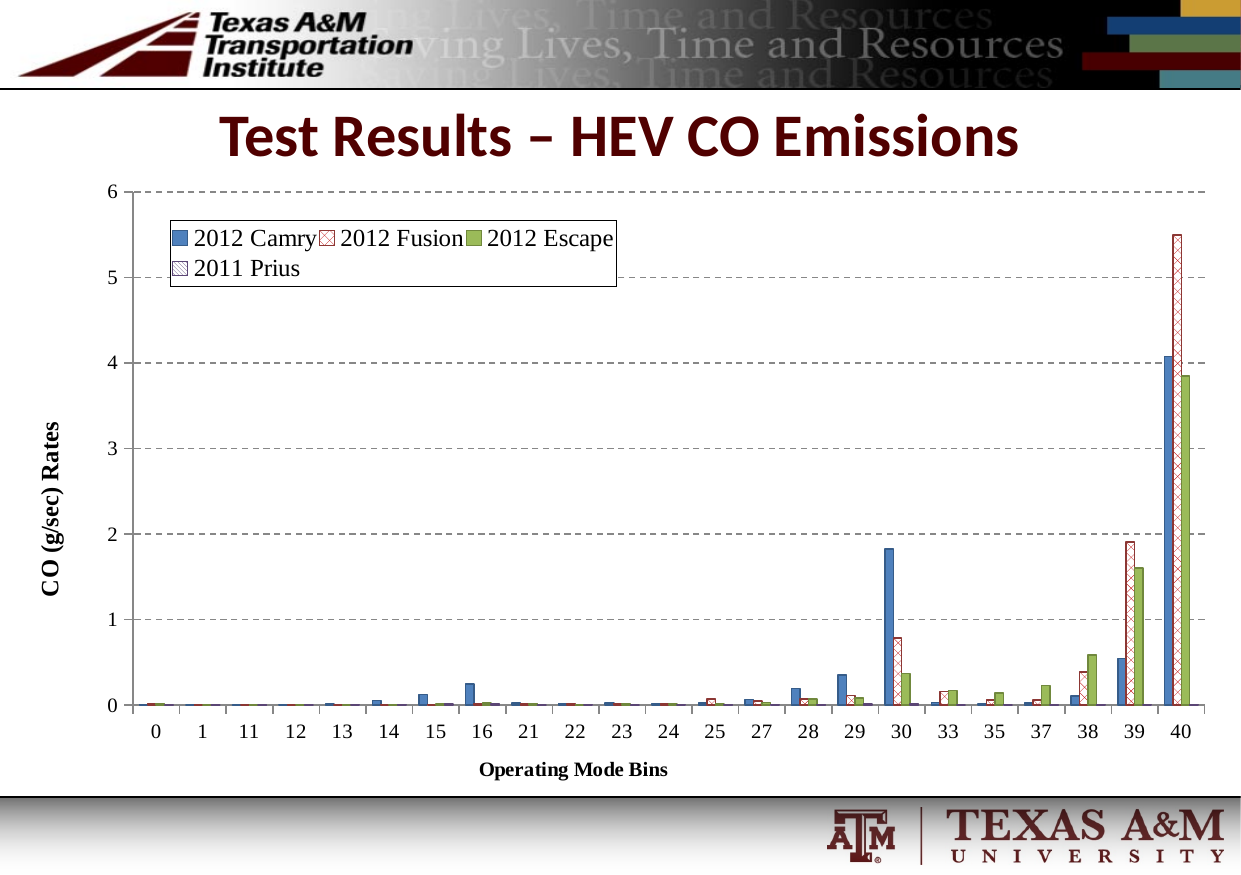
Which series has the highest value at operating mode bin 40? 2012 Fusion What is the title of the chart? Test Results – HEV CO Emissions At which operating mode bin does the 2012 Fusion reach its highest value? 40 What is the label of the y axis? CO (g/sec) Rates Is the value for 2012 Camry at bin 30 greater or less than 1? greater Which is larger at bin 39, the value for 2012 Fusion or 2012 Escape? 2012 Fusion Which is larger at bin 30, the value for 2012 Camry or 2012 Fusion? 2012 Camry Is the value for 2012 Escape at bin 40 greater or less than 4? less How many operating mode bins are shown on the x axis? 23 How many series does the legend list? 4 Is the value for 2012 Fusion at bin 40 greater or less than 5? greater What kind of chart is shown on the slide? bar chart